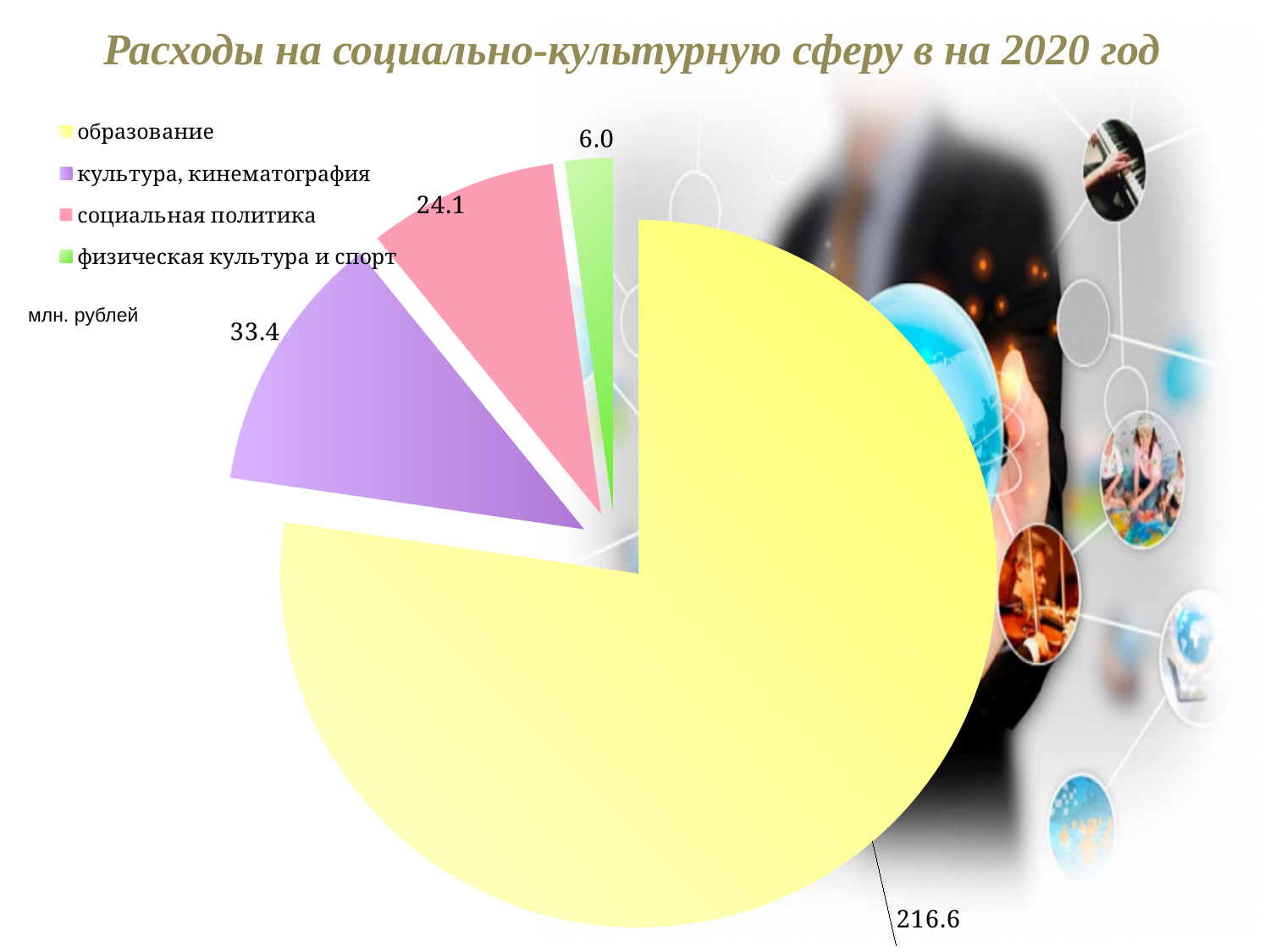
Which is larger, the value for социальная политика or the value for физическая культура и спорт? социальная политика How many categories does the pie chart have? 4 Which category has the smallest slice of the pie? физическая культура и спорт What type of chart is shown on the slide? pie chart Which category has the largest slice of the pie? образование What is the value for культура, кинематография? 33.4 What is the value for социальная политика? 24.1 What is the value for образование? 216.6 What is the difference between the values for культура, кинематография and социальная политика? 9.3 What share of the pie does образование represent, to the nearest whole percent? 77% What is the value for физическая культура и спорт? 6.0 What unit of measurement is indicated for the chart values? млн. рублей